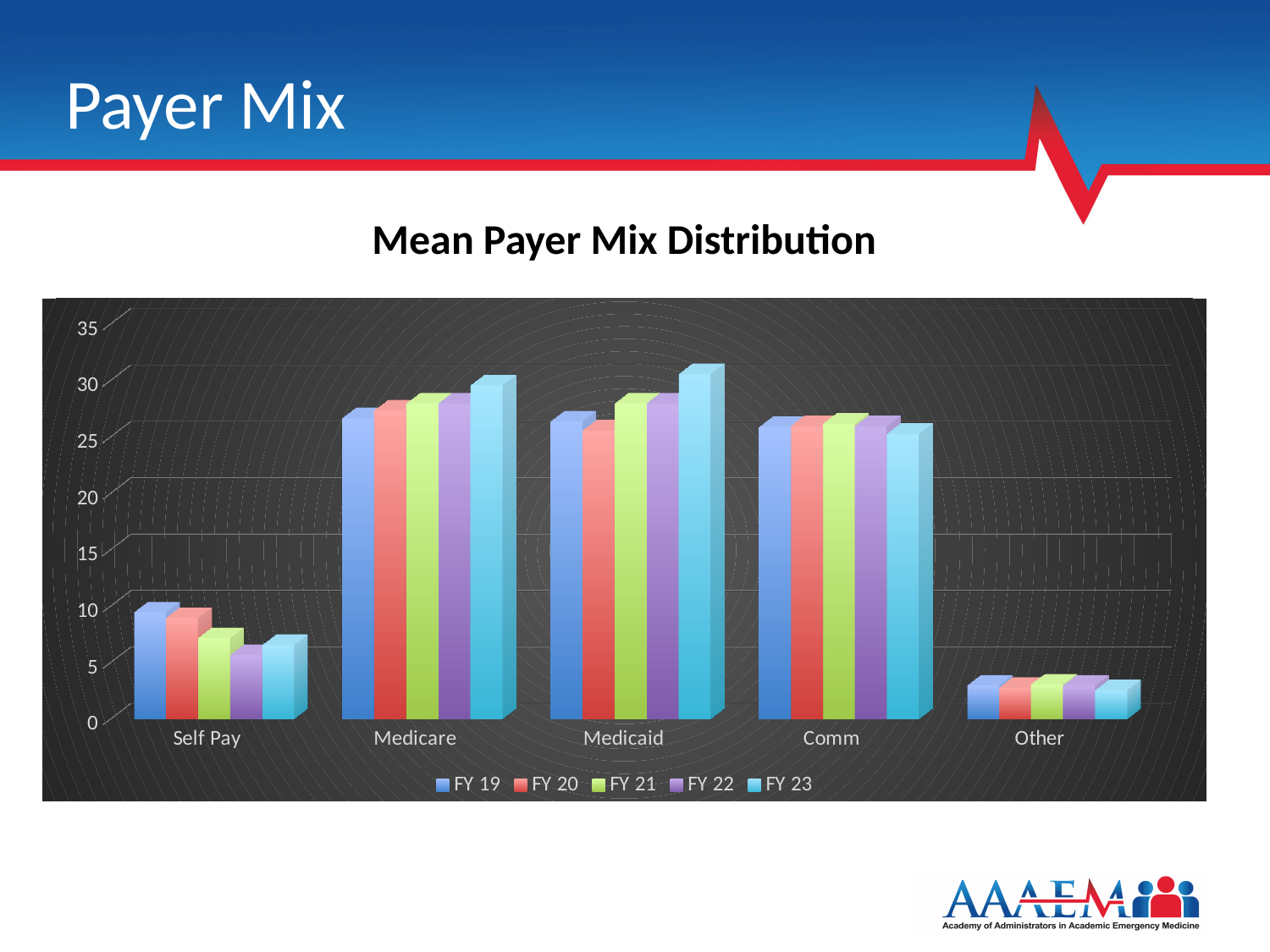
Is the value for Medicare in FY 23 greater or less than 25? greater Which payer category has the lowest values across all fiscal years? Other How many payer categories are shown on the x axis of the chart? 5 Is the value for Self Pay in FY 19 greater or less than 15? less What kind of chart is shown on the slide? bar chart Which is larger, the Self Pay value for FY 19 or the Other value for FY 19? Self Pay Which is larger, the Medicaid value for FY 23 or the Medicaid value for FY 20? FY 23 Which fiscal years are listed in the chart's legend? FY 19, FY 20, FY 21, FY 22, FY 23 Do the Self Pay values rise or fall from FY 19 to FY 22? fall What is the title of the chart? Mean Payer Mix Distribution How many series does the chart's legend list? 5 Is the value for Other in FY 21 greater or less than 5? less